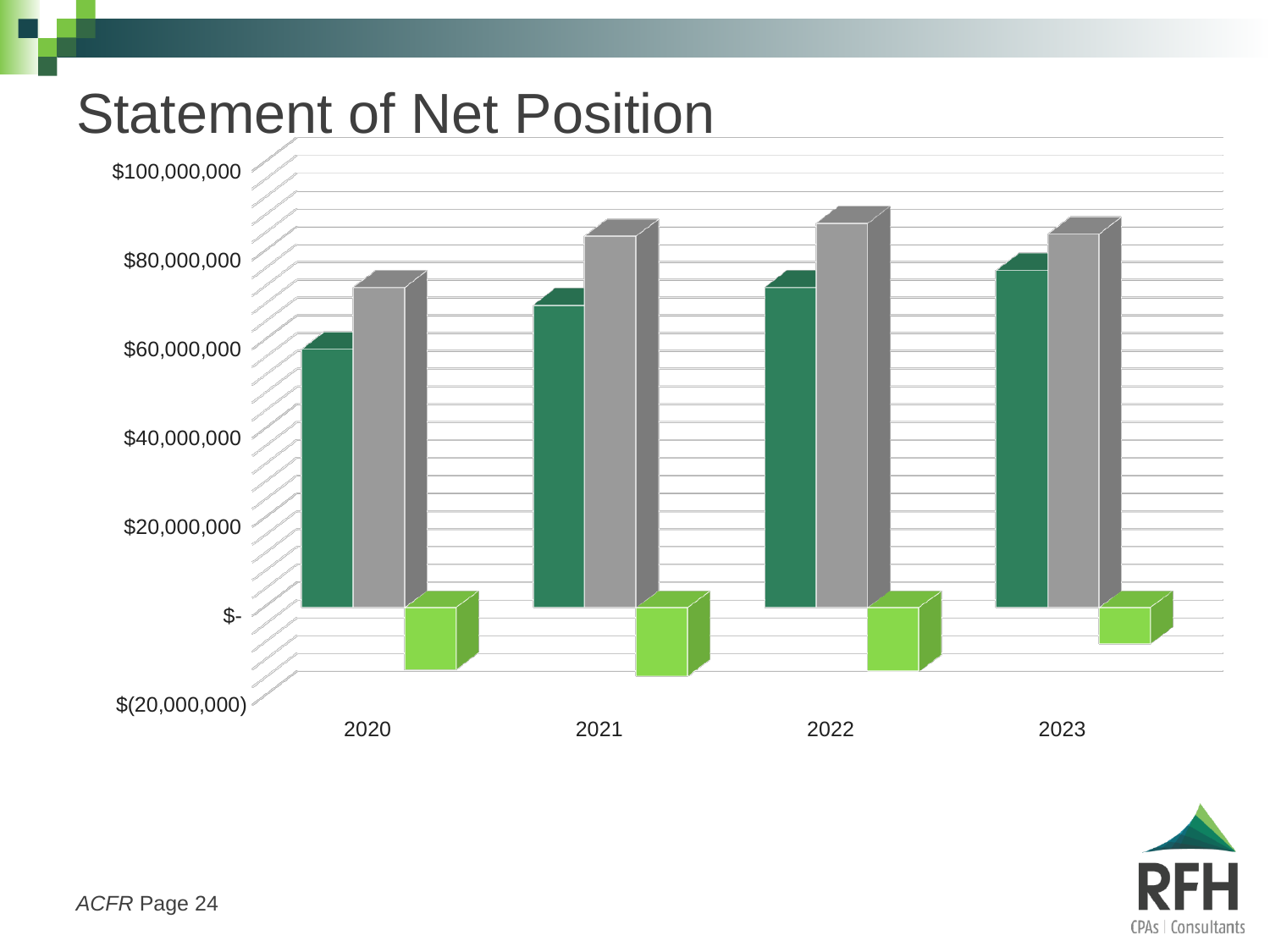
Do the dark green bars rise or fall from 2020 to 2023? rise Is the value of the light green bar for 2021 greater or less than $-? less Which year has the lowest dark green bar? 2020 Is the value of the dark green bar for 2023 greater or less than $80,000,000? less How many years are shown on the x axis of the chart? 4 How many bars are plotted for each year in the chart? 3 For 2021, which is larger, the dark green bar or the gray bar? the gray bar Is the value of the gray bar for 2022 greater or less than $80,000,000? greater Which year has the highest gray bar? 2022 What type of chart is shown on the slide? bar chart What is the title of the chart? Statement of Net Position